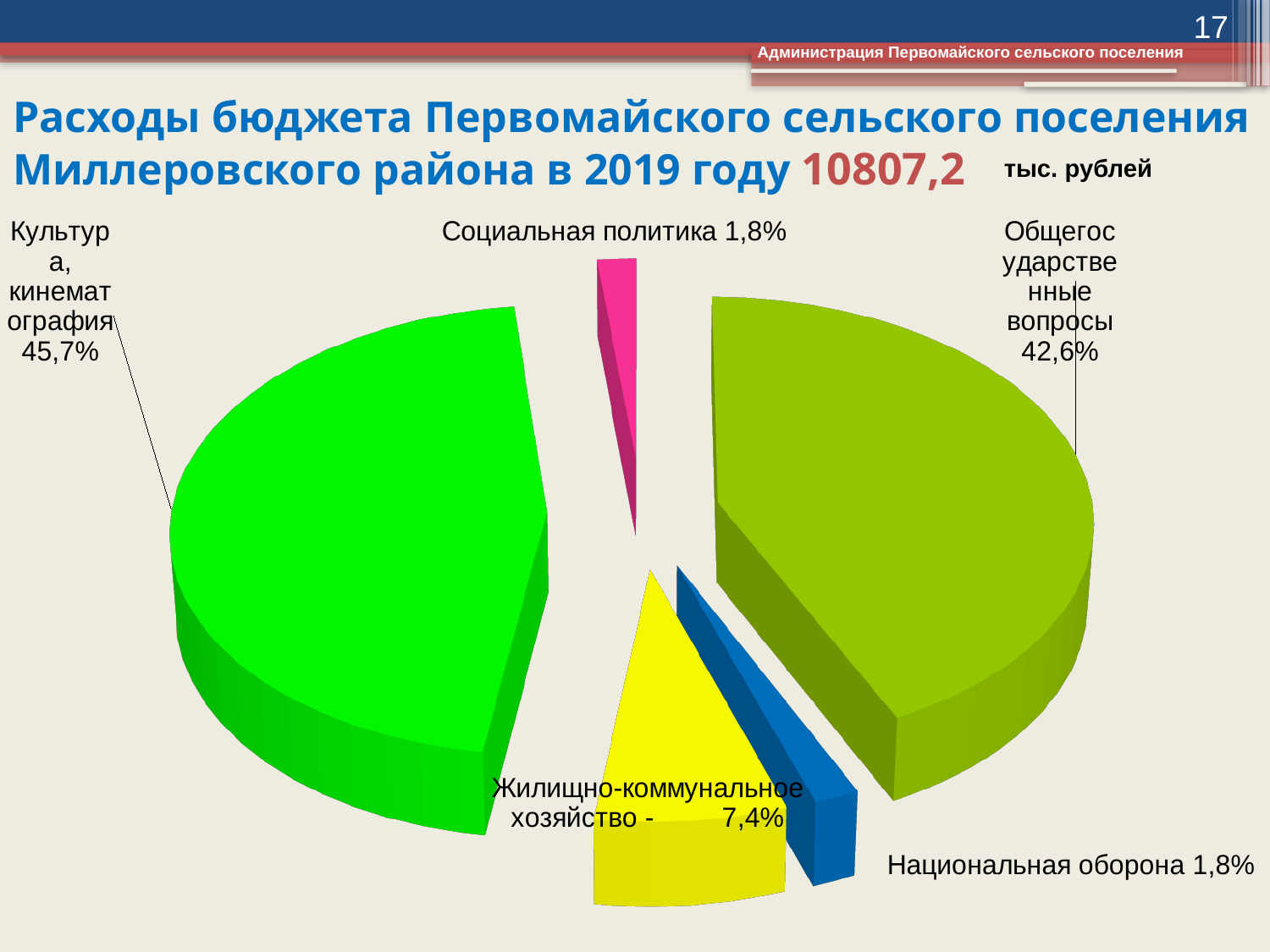
What share of the budget expenditures does Культура, кинематография account for? 45,7% What percentage is shown for Национальная оборона? 1,8% What percentage is shown for Общегосударственные вопросы? 42,6% By how many percentage points does Культура, кинематография exceed Общегосударственные вопросы? 3,1 percentage points How many slices does the pie chart have? 5 By how many percentage points does Общегосударственные вопросы exceed Жилищно-коммунальное хозяйство? 35,2 percentage points What percentage is shown for Социальная политика? 1,8% Which is larger: the share for Культура, кинематография or for Общегосударственные вопросы? Культура, кинематография What total budget expenditure amount is stated in the slide title? 10807,2 тыс. рублей What share is labelled for Жилищно-коммунальное хозяйство? 7,4% Which category has the largest share of the pie? Культура, кинематография What type of chart is shown on the slide? Pie chart